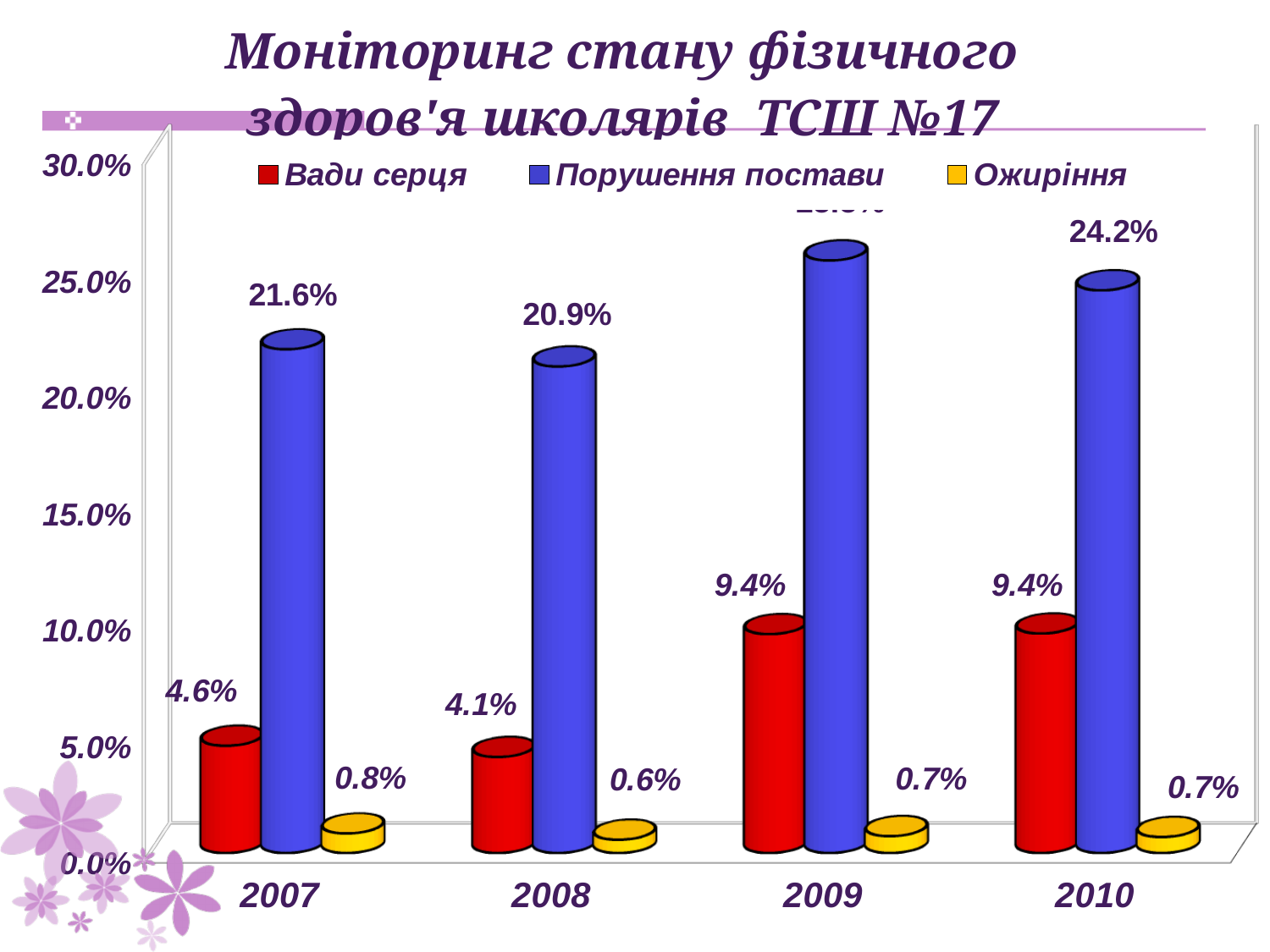
Is the value for Порушення постави in 2009 greater or less than 25.0%? greater What kind of chart is shown on the slide? bar chart What colour are the bars for Ожиріння? yellow How many years are shown on the x axis? 4 What is the difference between the Вади серця values for 2009 and 2007? 4.8% What is the value for Порушення постави in 2010? 24.2% In which year is the value for Ожиріння the lowest? 2008 How many series does the legend list? 3 In which year is the value for Порушення постави the highest? 2009 Which year has the larger value for Порушення постави, 2007 or 2008? 2007 What is the value for Ожиріння in 2008? 0.6% What is the value for Вади серця in 2007? 4.6%